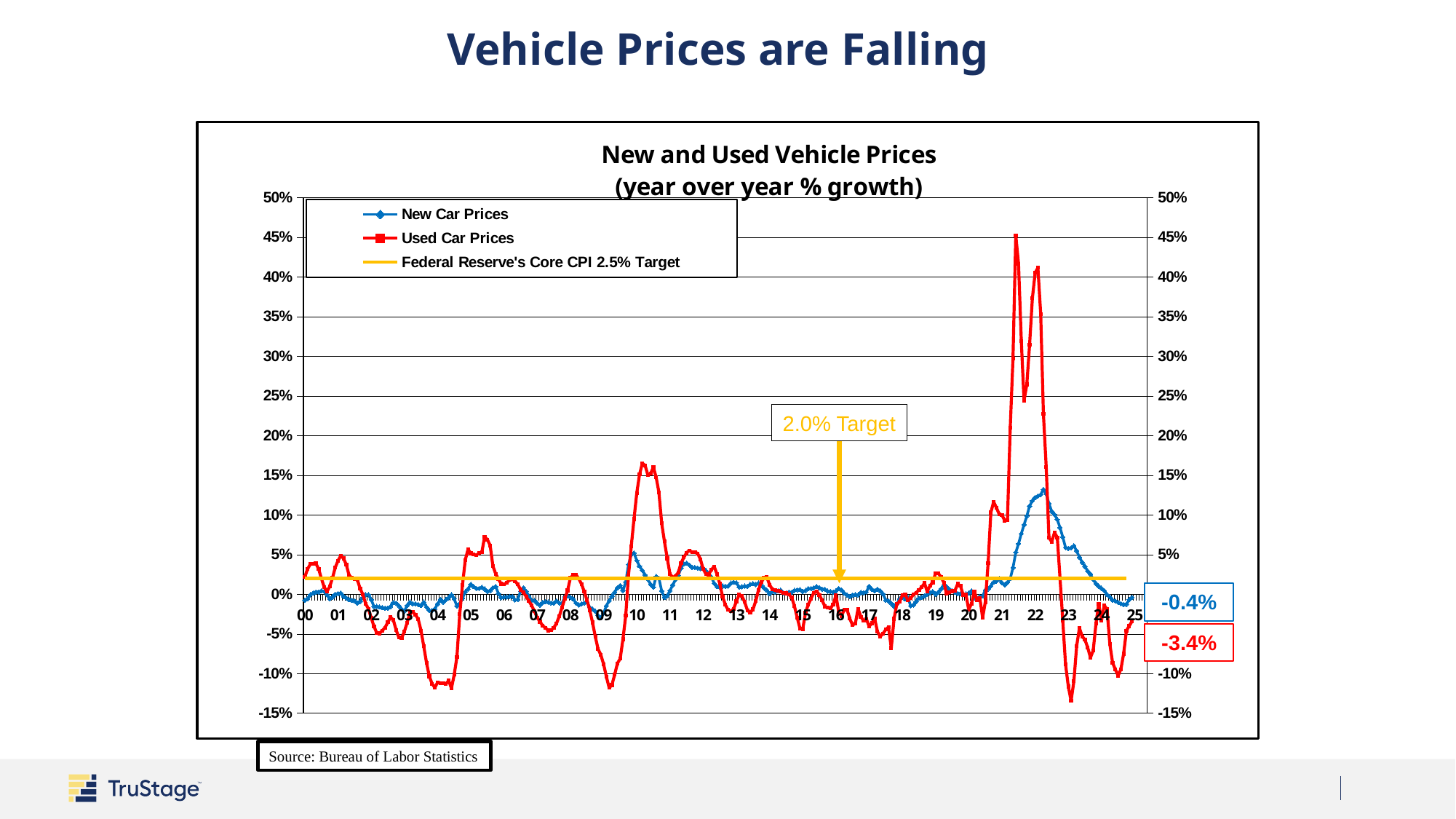
How many series does the legend list? 3 What is the difference between the latest labelled New Car Prices value (-0.4%) and the latest labelled Used Car Prices value (-3.4%)? 3.0 percentage points Is the peak value of New Car Prices around 2022 greater or less than 10%? greater What is the latest labelled value for New Car Prices? -0.4% At the end of the chart, which series has the higher value, New Car Prices or Used Car Prices? New Car Prices Is the lowest value of Used Car Prices around 2023 greater or less than -10%? less Which series reaches the highest value anywhere on the chart? Used Car Prices What is the title of the chart? New and Used Vehicle Prices (year over year % growth) What kind of chart is shown on the slide? line chart What is the latest labelled value for Used Car Prices? -3.4% Is the peak value of Used Car Prices around 2021 greater or less than 40%? greater Between 22 and 23 on the x axis, do Used Car Prices rise or fall? fall